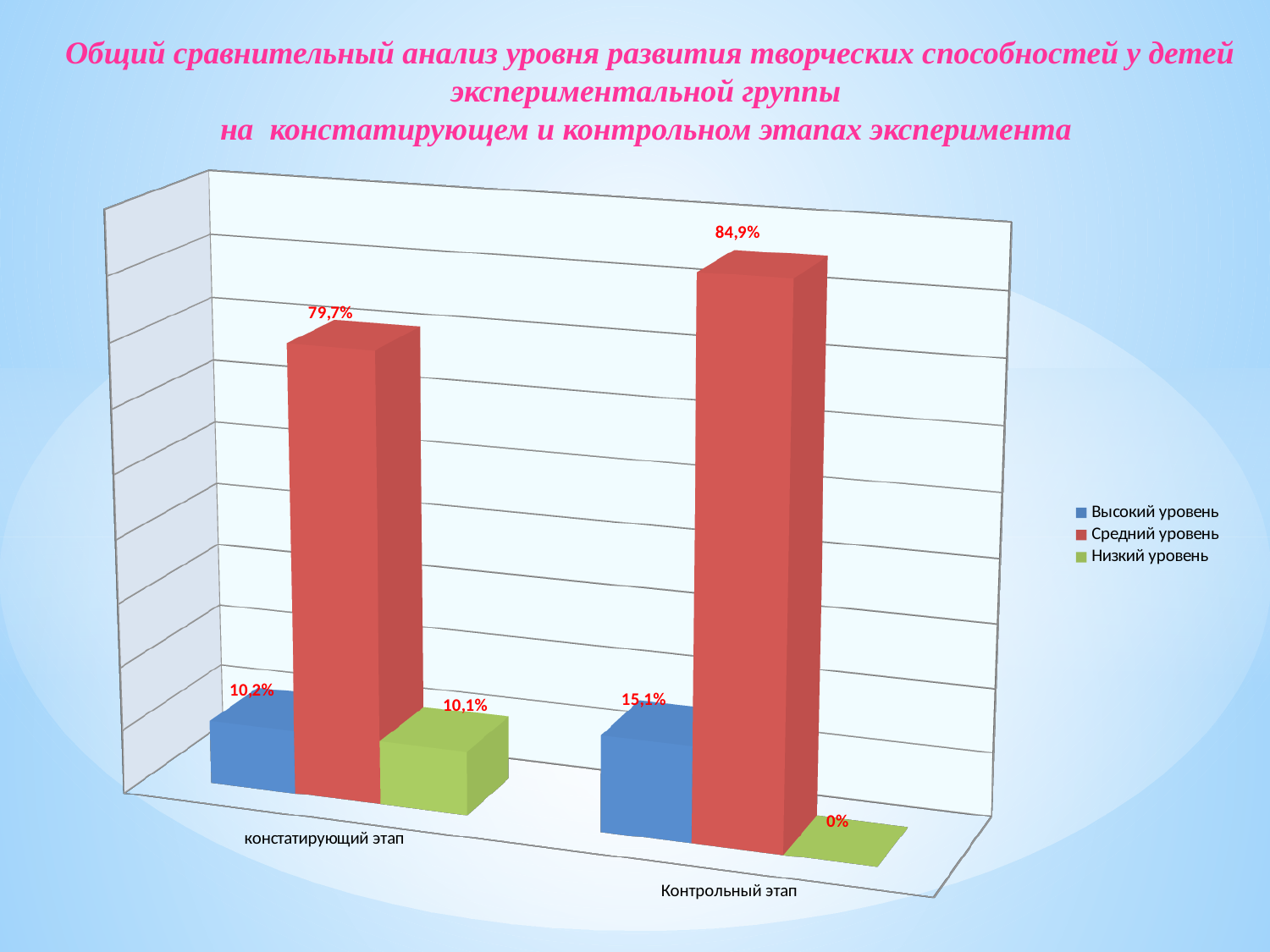
Which series has the lowest value at the Контрольный этап? Низкий уровень How many series does the legend list? 3 What is the value for Средний уровень at the констатирующий этап? 79,7% What is the value for Низкий уровень at the Контрольный этап? 0% What is the difference between the Средний уровень values at the Контрольный этап and the констатирующий этап? 5,2% What colour are the bars for Низкий уровень? Green Which is larger: Высокий уровень at the констатирующий этап or Высокий уровень at the Контрольный этап? Высокий уровень at the Контрольный этап What kind of chart is shown on the slide? Bar chart What is the value for Средний уровень at the Контрольный этап? 84,9% What is the value for Высокий уровень at the Контрольный этап? 15,1% How many categories (stages) are shown on the x axis? 2 Which series has the highest value at the констатирующий этап? Средний уровень